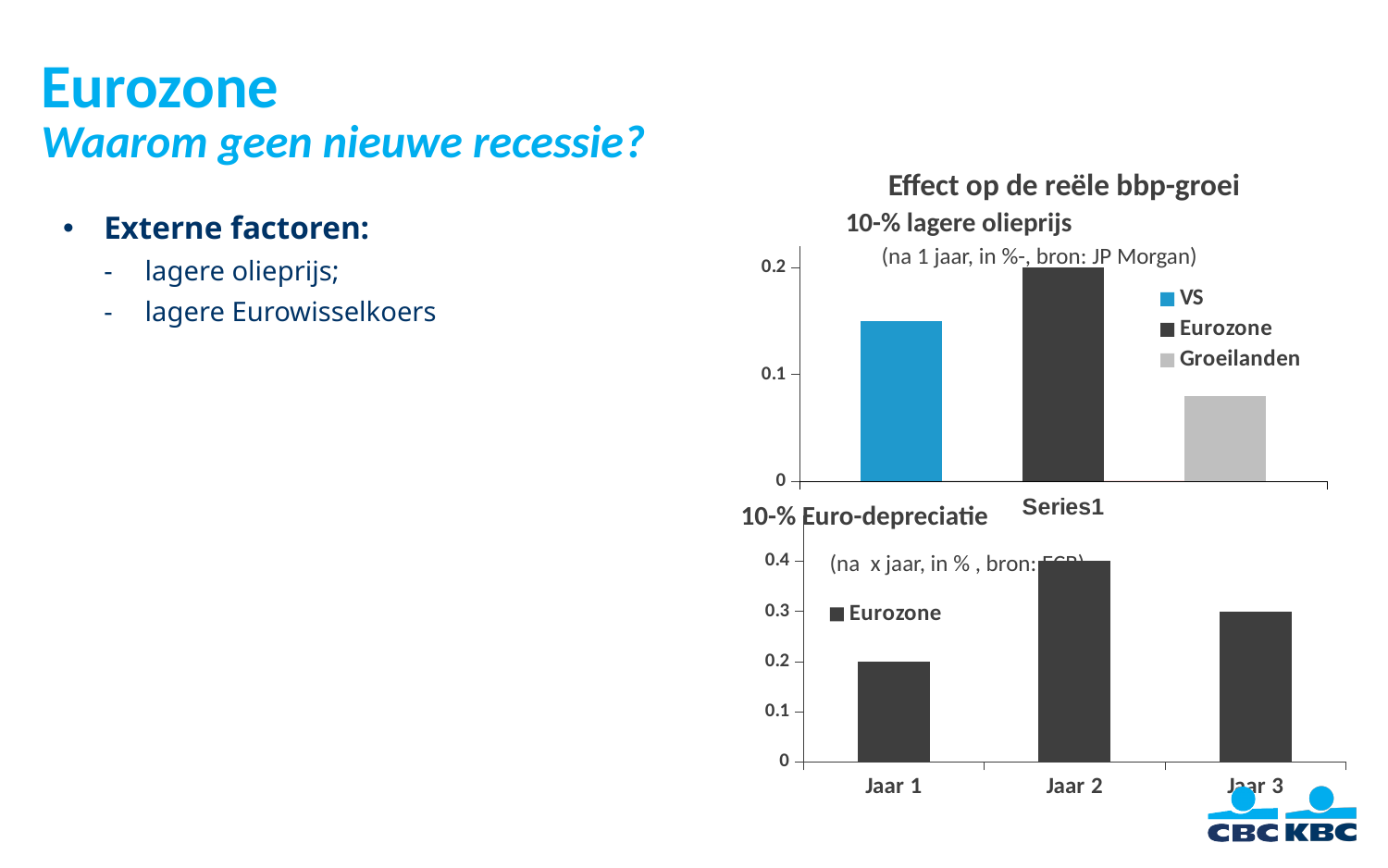
In the '10-% lagere olieprijs' chart, what is the value for Eurozone? 0.2 In the '10-% Euro-depreciatie' chart, what is the value for Jaar 2? 0.4 In the '10-% Euro-depreciatie' chart, what is the difference between the values for Jaar 2 and Jaar 1? 0.2 In the '10-% lagere olieprijs' chart, is the value for Groeilanden greater or less than 0.1? less In the '10-% lagere olieprijs' chart, is the value for VS greater or less than 0.1? greater In the '10-% Euro-depreciatie' chart, which year has the highest value? Jaar 2 In the '10-% Euro-depreciatie' chart, which is larger, the value for Jaar 3 or Jaar 1? Jaar 3 In the '10-% lagere olieprijs' chart, which series has the lowest value? Groeilanden In the '10-% lagere olieprijs' chart, which series has the highest value? Eurozone In the '10-% lagere olieprijs' chart, how many series does the legend list? 3 In the '10-% Euro-depreciatie' chart, how many categories are shown on the x axis? 3 In the '10-% lagere olieprijs' chart, what kind of chart is shown? bar chart